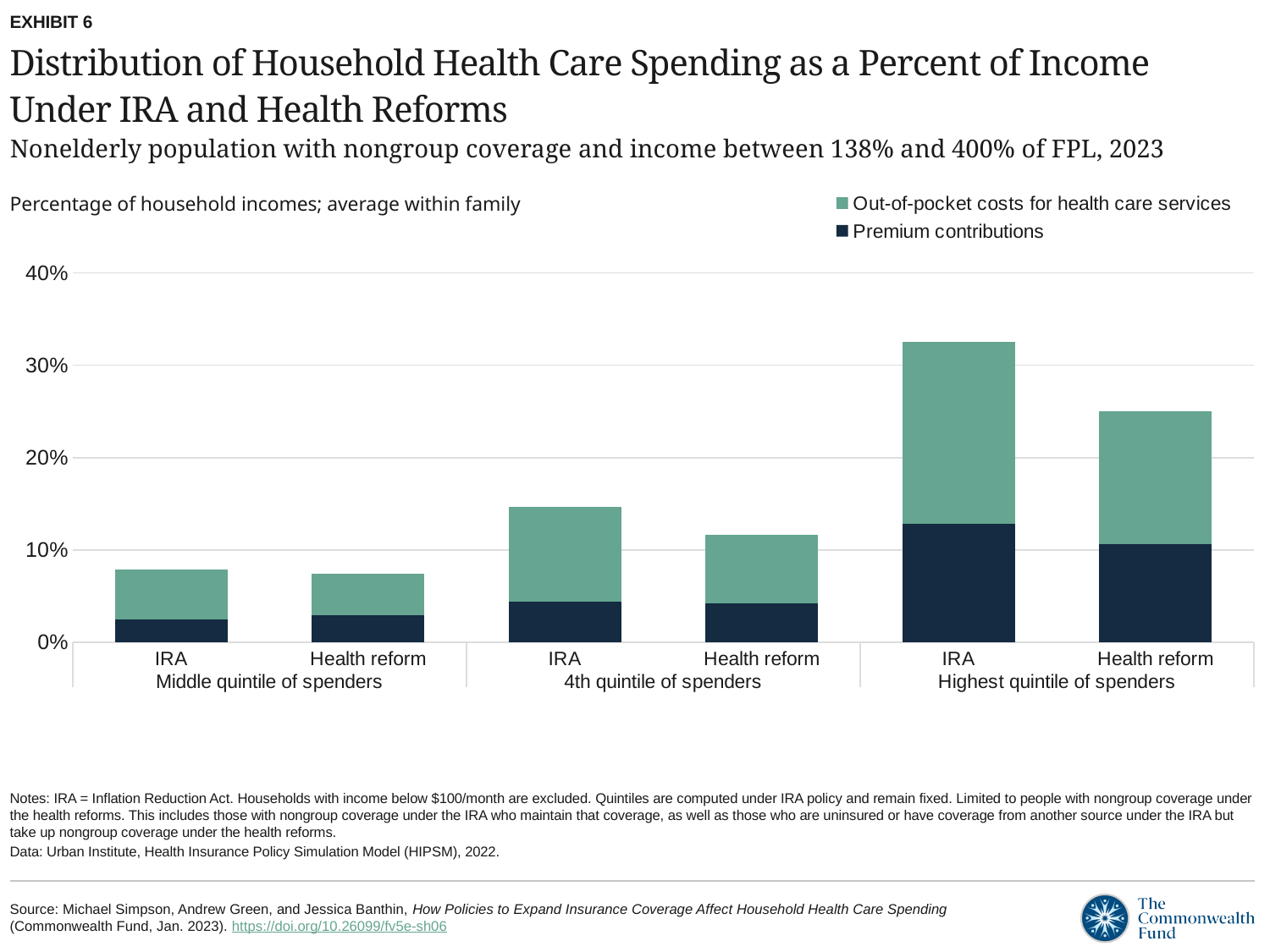
Is the total for Health reform in the Highest quintile of spenders greater or less than 30%? less Which bar has the highest total household health care spending as a percent of income? IRA, Highest quintile of spenders Is the total for IRA in the Highest quintile of spenders greater or less than 30%? greater In the Highest quintile of spenders, which has the larger total: IRA or Health reform? IRA Is the Premium contributions portion for IRA in the Highest quintile of spenders greater or less than 10%? greater In the 4th quintile of spenders, which has the larger total: IRA or Health reform? IRA Moving from the Middle quintile to the Highest quintile of spenders, do the IRA totals rise or fall? rise How many series does the legend list? 2 What kind of chart is shown on the slide? Stacked bar chart How many bars are plotted in the chart? 6